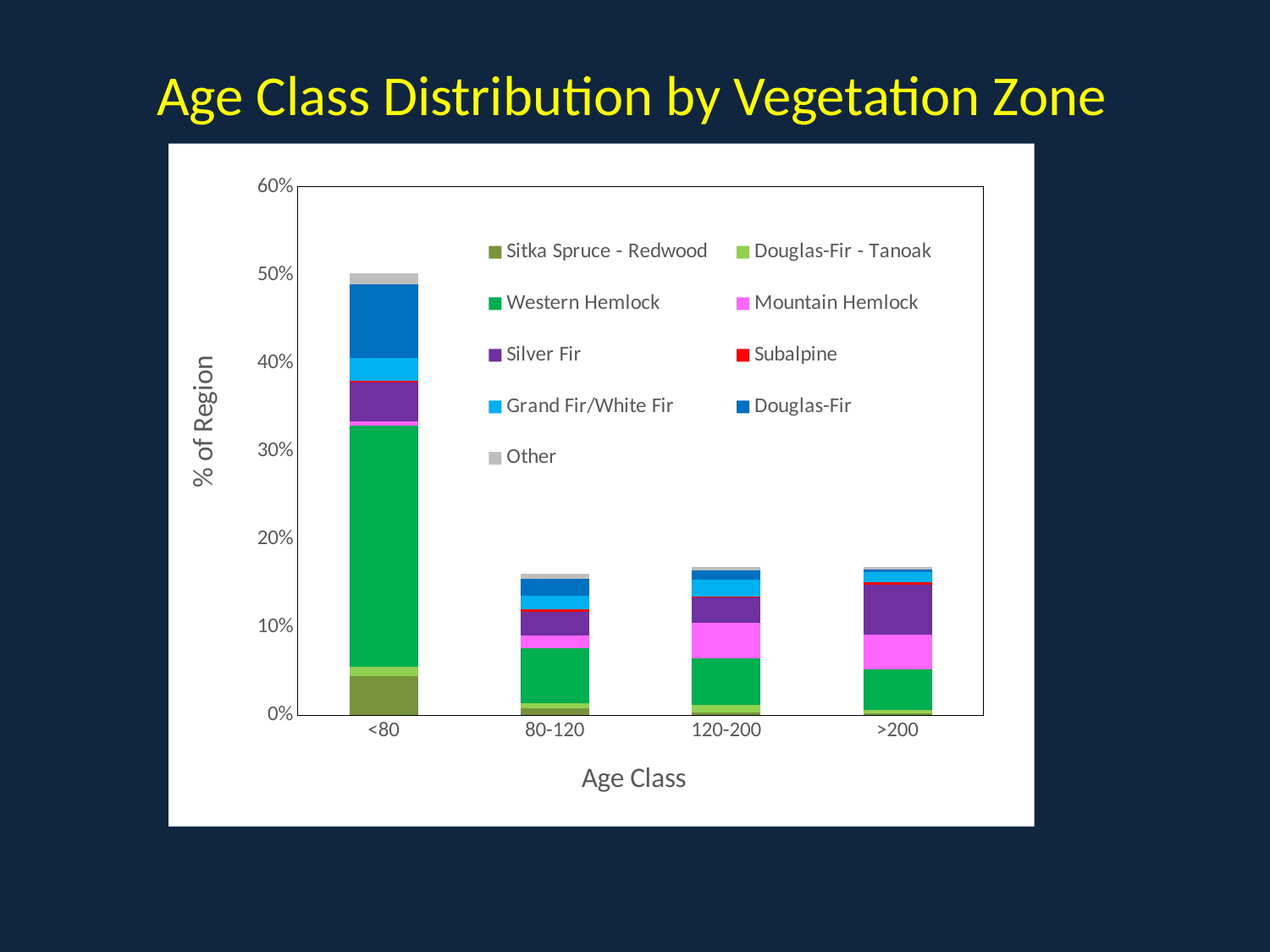
What is the label on the y axis? % of Region How many age class categories are shown on the x axis? 4 How many series does the legend list? 9 Which has a larger total, the <80 age class or the 120-200 age class? <80 Is the total for the >200 age class greater or less than 10%? greater What kind of chart is shown on the slide? stacked bar chart Is the total for the <80 age class greater or less than 40%? greater What is the title of the chart? Age Class Distribution by Vegetation Zone Which age class has the tallest stacked bar? <80 Is the total for the 80-120 age class greater or less than 20%? less